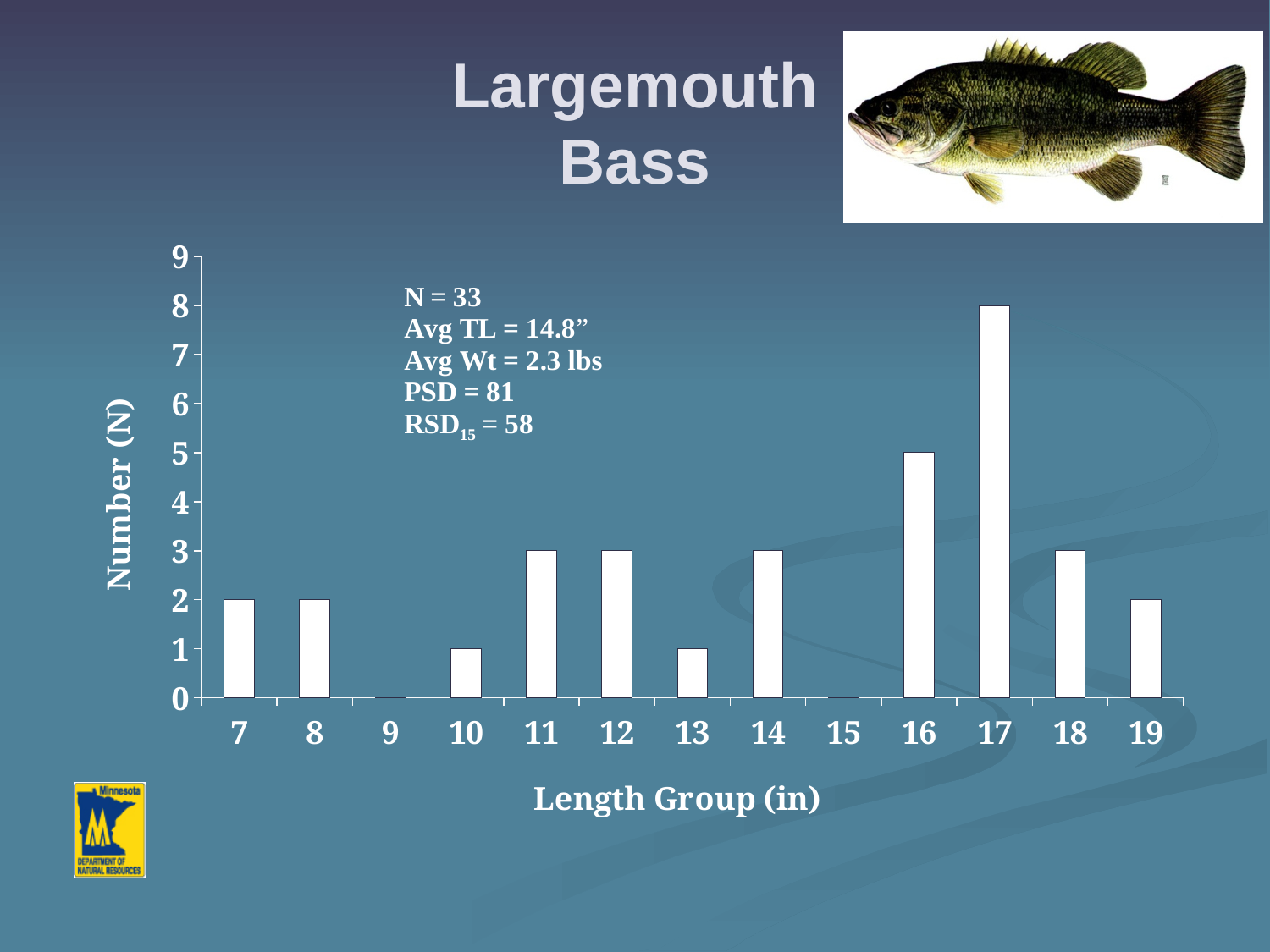
What is the label of the y axis? Number (N) Which length group has the highest number of largemouth bass? 17 What is the difference in number of fish between the 17-inch and 16-inch length groups? 3 What kind of chart is shown on the slide? bar chart What is the number of fish in the 16-inch length group? 5 What is the label of the x axis? Length Group (in) Which has more fish, the 11-inch length group or the 13-inch length group? 11-inch length group Is the value for the 17-inch length group greater or less than 6? greater How many length groups are shown on the x axis? 13 What is the number of fish in the 17-inch length group? 8 What is the number of fish in the 19-inch length group? 2 What is the number of fish in the 10-inch length group? 1